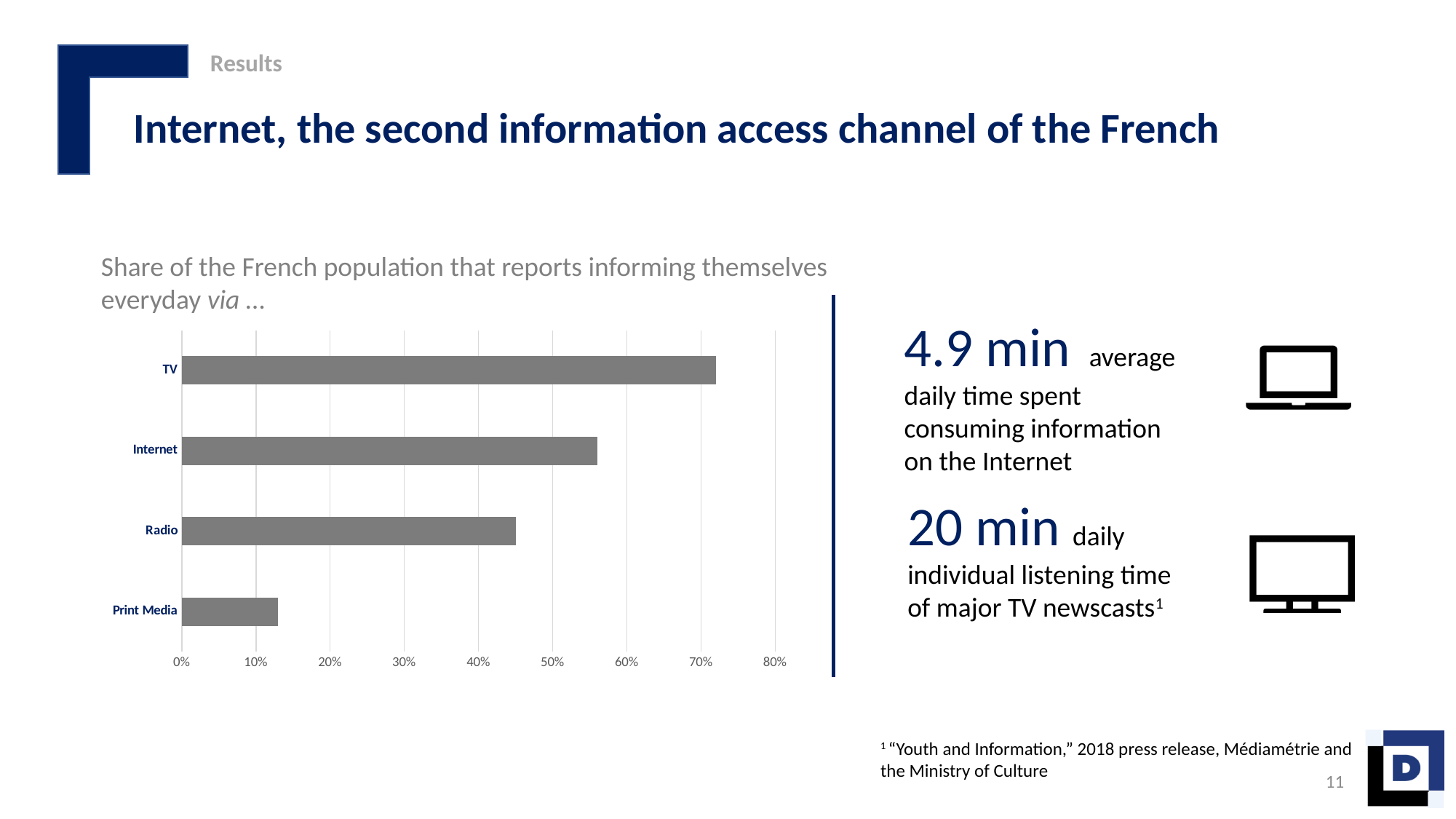
Which has a larger share, Internet or Radio? Internet Which has a larger share, Radio or Print Media? Radio How many categories are plotted in the chart? 4 What kind of chart is shown on the slide? bar chart What is the highest value shown on the chart's percentage axis? 80% Is the value for Radio greater or less than 50%? less Is the value for Print Media greater or less than 20%? less Which category has the lowest share in the chart? Print Media What colour are the bars in the chart? grey Which category has the highest share in the chart? TV Is the value for Internet greater or less than 50%? greater